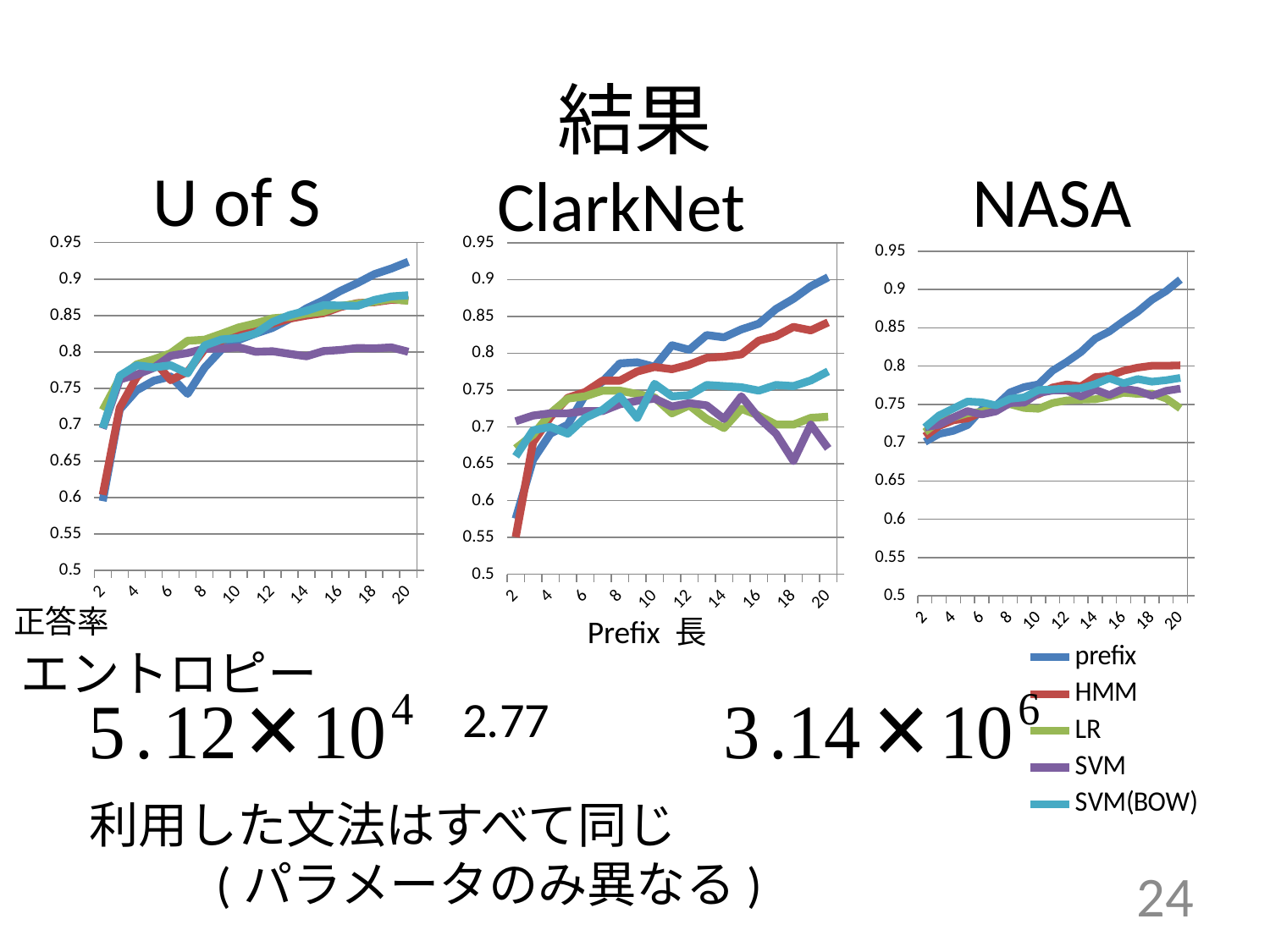
In the U of S chart, is the value for HMM at prefix length 2 greater or less than 0.65? less In the NASA chart, is the value for LR at prefix length 20 greater or less than 0.8? less In the NASA chart, does the prefix series rise or fall as prefix length increases? rise How many series does the legend list for the charts? 5 In the ClarkNet chart, which series is lowest at prefix length 20? SVM In the U of S chart, at prefix length 20, which is larger: prefix or SVM? prefix What kind of chart is the U of S chart? line chart What are the titles of the three charts on the slide, from left to right? U of S, ClarkNet, NASA In the NASA chart, is the value for prefix at prefix length 20 greater or less than 0.85? greater Which series is drawn in blue in the legend? prefix In the ClarkNet chart, which series is highest at prefix length 20? prefix